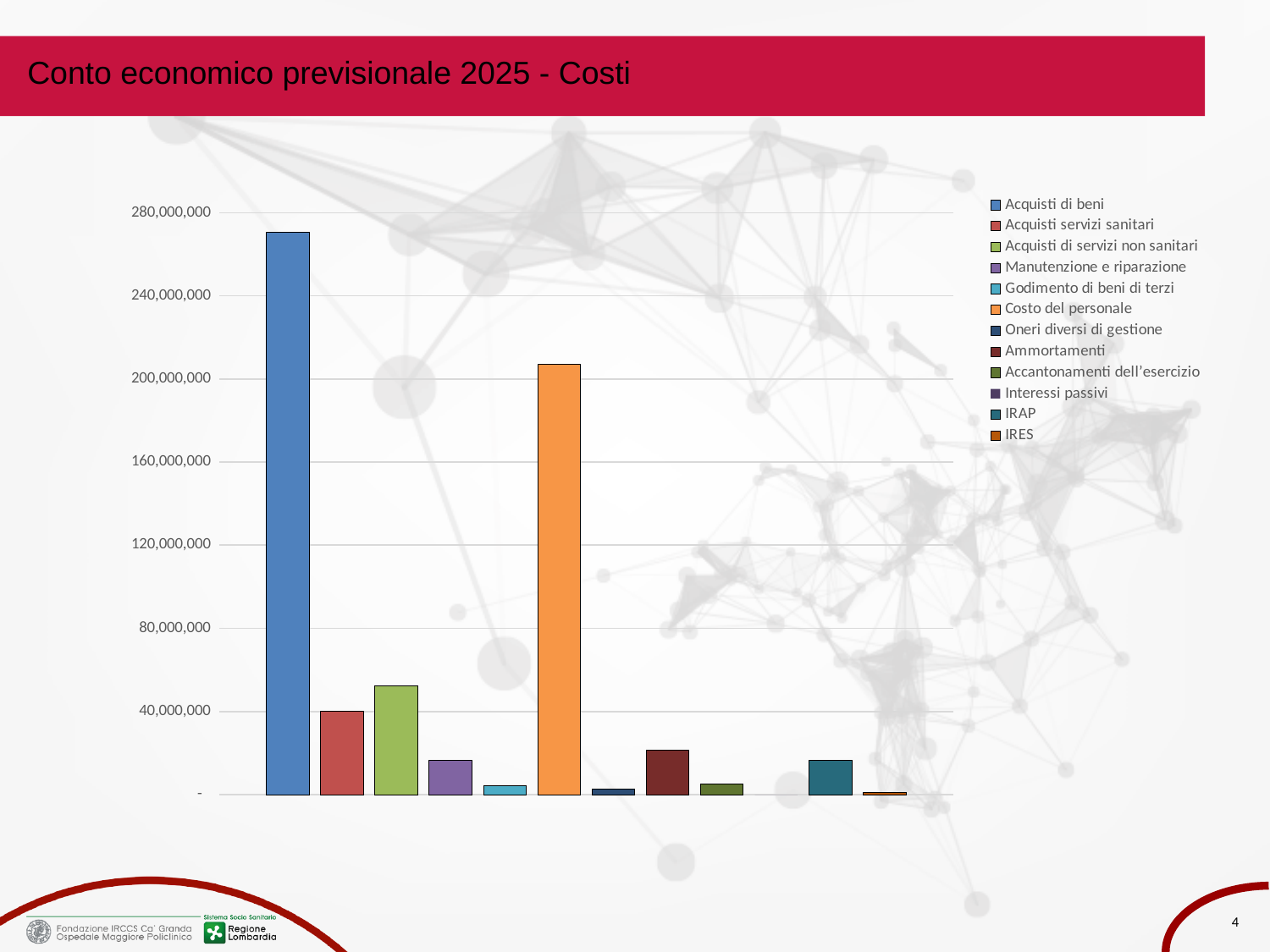
Which is larger, Manutenzione e riparazione or Godimento di beni di terzi? Manutenzione e riparazione Is the value for Ammortamenti greater or less than 40,000,000? less What kind of chart is shown on the slide? Bar chart What is the title of the slide containing the chart? Conto economico previsionale 2025 - Costi Which cost item has the highest value? Acquisti di beni Is the value for Acquisti di beni greater or less than 240,000,000? greater Which is larger, Acquisti di beni or Costo del personale? Acquisti di beni Is the value for Costo del personale greater or less than 200,000,000? greater Which is larger, Acquisti di servizi non sanitari or Acquisti servizi sanitari? Acquisti di servizi non sanitari How many series does the legend list? 12